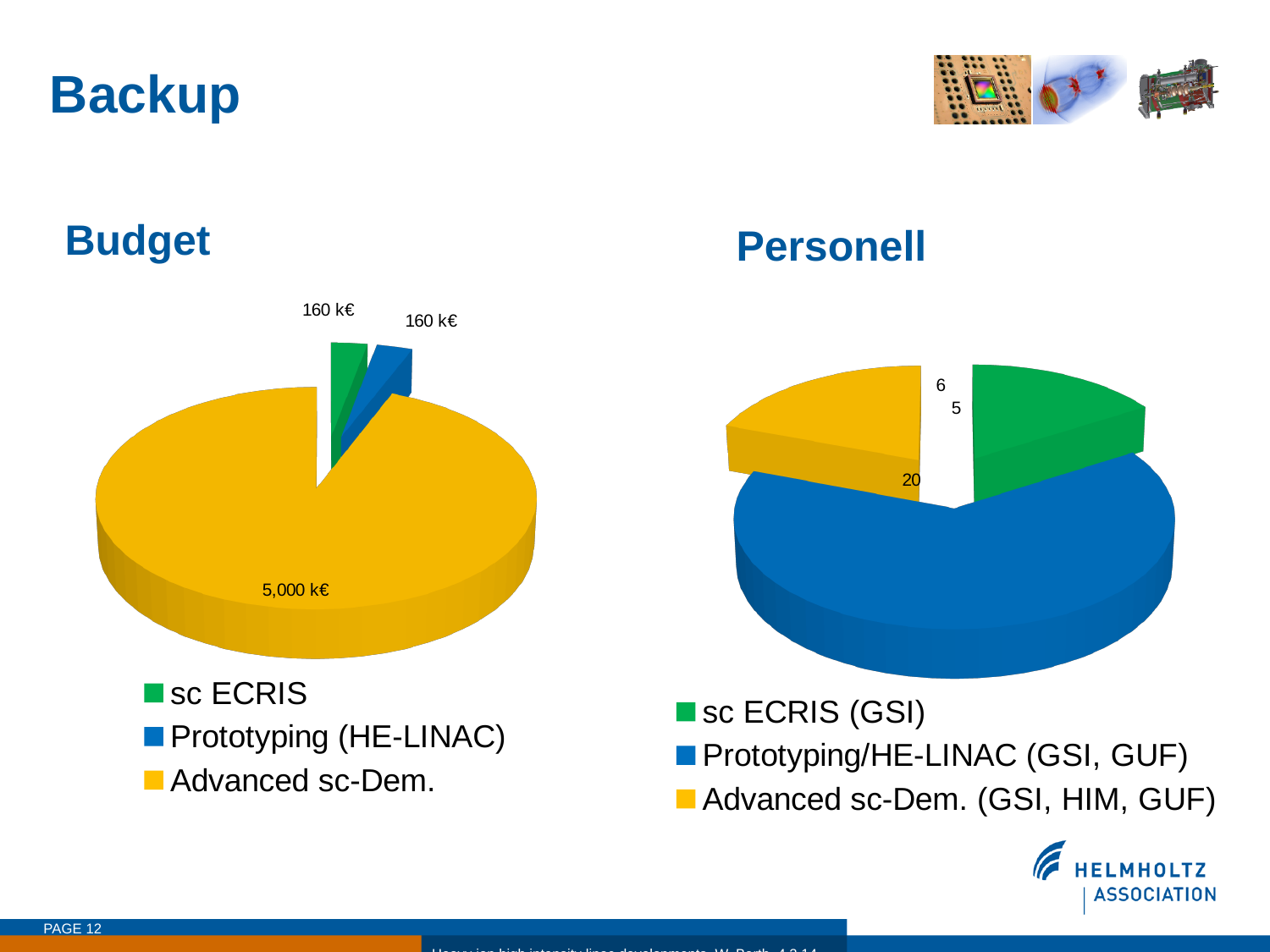
What kind of chart is the Budget chart? Pie chart In the Budget chart, what is the value for sc ECRIS? 160 k€ How many categories does the legend of the Personell chart list? 3 In the Budget chart, what is the total of all three slices? 5,320 k€ In the Budget chart, what is the value for Advanced sc-Dem.? 5,000 k€ In the Budget chart, what is the difference between Advanced sc-Dem. and Prototyping (HE-LINAC)? 4,840 k€ In the Budget chart, which category has the largest slice? Advanced sc-Dem. In the Personell chart, which category has the smallest slice? sc ECRIS (GSI) In the Personell chart, what is the total of all three slices? 31 In the Personell chart, what is the value for Prototyping/HE-LINAC (GSI, GUF)? 20 In the Personell chart, what is the value for sc ECRIS (GSI)? 5 In the Personell chart, which is larger: Advanced sc-Dem. (GSI, HIM, GUF) or sc ECRIS (GSI)? Advanced sc-Dem. (GSI, HIM, GUF)